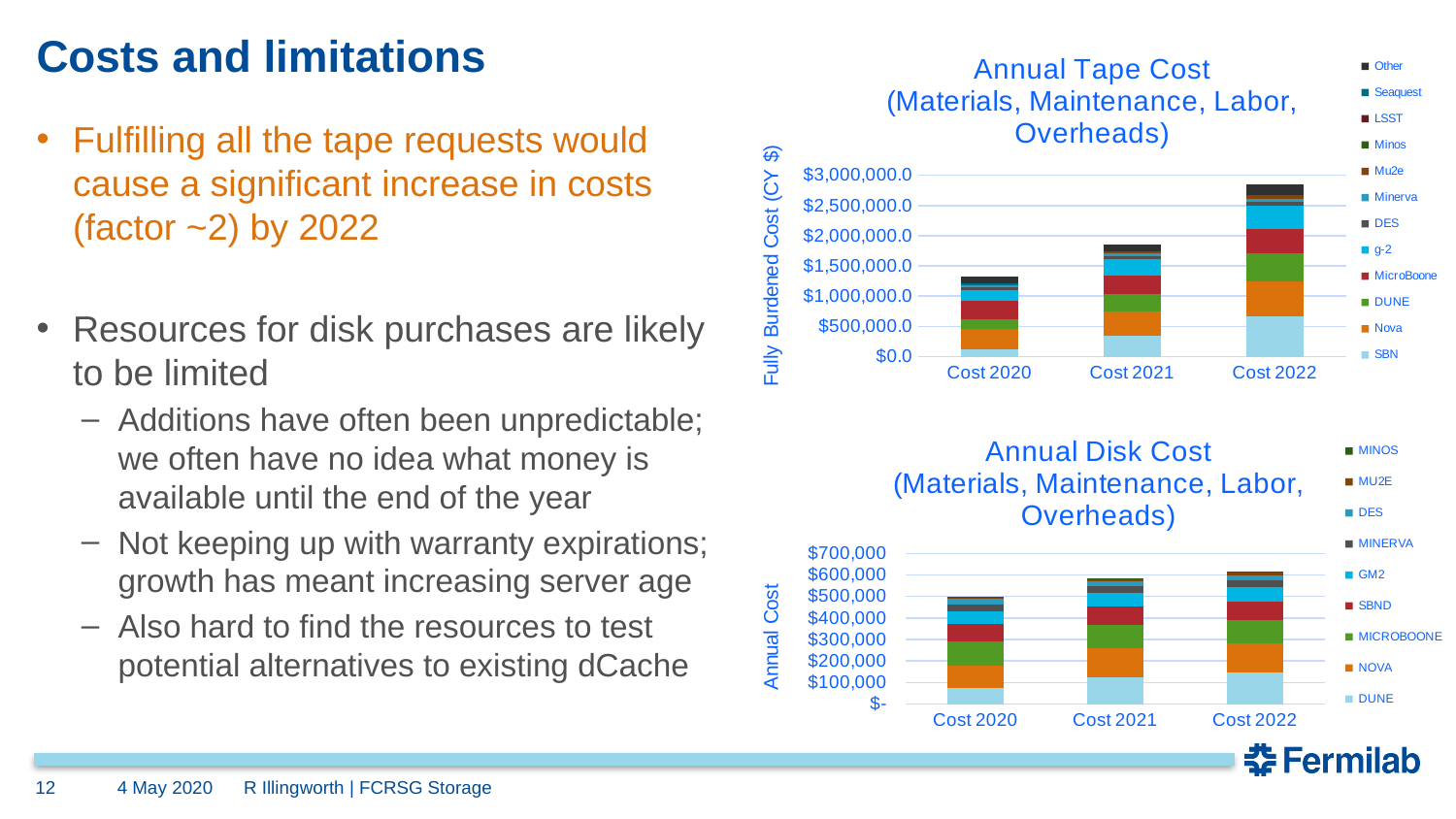
In the Annual Disk Cost chart, which is larger, the total for Cost 2020 or the total for Cost 2022? Cost 2022 In the Annual Tape Cost chart, is the total for Cost 2020 greater or less than $1,500,000.0? less In the Annual Tape Cost chart, how many series does the legend list? 12 In the Annual Tape Cost chart, do the total costs rise or fall from Cost 2020 to Cost 2022? rise In the Annual Disk Cost chart, is the total for Cost 2020 greater or less than $600,000? less In the Annual Disk Cost chart, how many years are shown on the x axis? 3 In the Annual Tape Cost chart, which year has the lowest total cost? Cost 2020 What is the y-axis label of the Annual Tape Cost chart? Fully Burdened Cost (CY $) In the Annual Disk Cost chart, how many series does the legend list? 9 In the Annual Tape Cost chart, is the total for Cost 2022 greater or less than $2,500,000.0? greater What kind of chart is the Annual Disk Cost chart? stacked bar chart In the Annual Tape Cost chart, which year has the highest total cost? Cost 2022